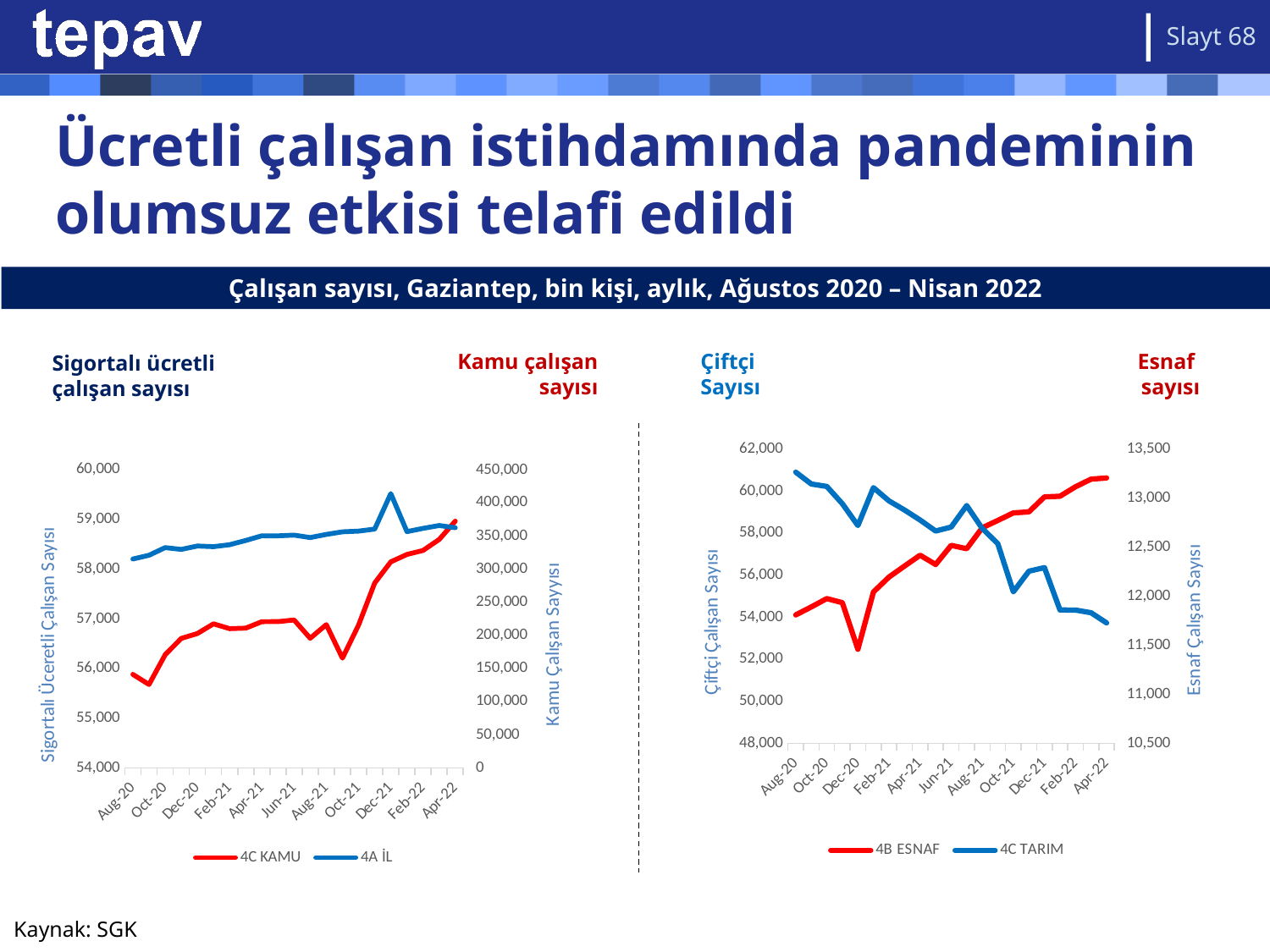
How many series does the legend of the left chart list? 2 What kind of chart is the right chart (Çiftçi Sayısı / Esnaf sayısı)? Line chart In the left chart, does the 4C KAMU series rise or fall overall from Aug-20 to Apr-22? Rise In the left chart, is the value of 4C KAMU at Apr-22 greater or less than 350,000? less Which series in the left chart is drawn in red? 4C KAMU In the right chart, is the value of 4B ESNAF at Apr-22 greater or less than 13,000? greater In the right chart, is the value of 4C TARIM at Aug-20 greater or less than 60,000? less How many series does the legend of the right chart list? 2 In the right chart, does the 4C TARIM series rise or fall from Aug-20 to Apr-22? Fall In the right chart, does the 4B ESNAF series rise or fall from Aug-20 to Apr-22? Rise What kind of chart is the left chart (Sigortalı ücretli çalışan sayısı / Kamu çalışan sayısı)? Line chart